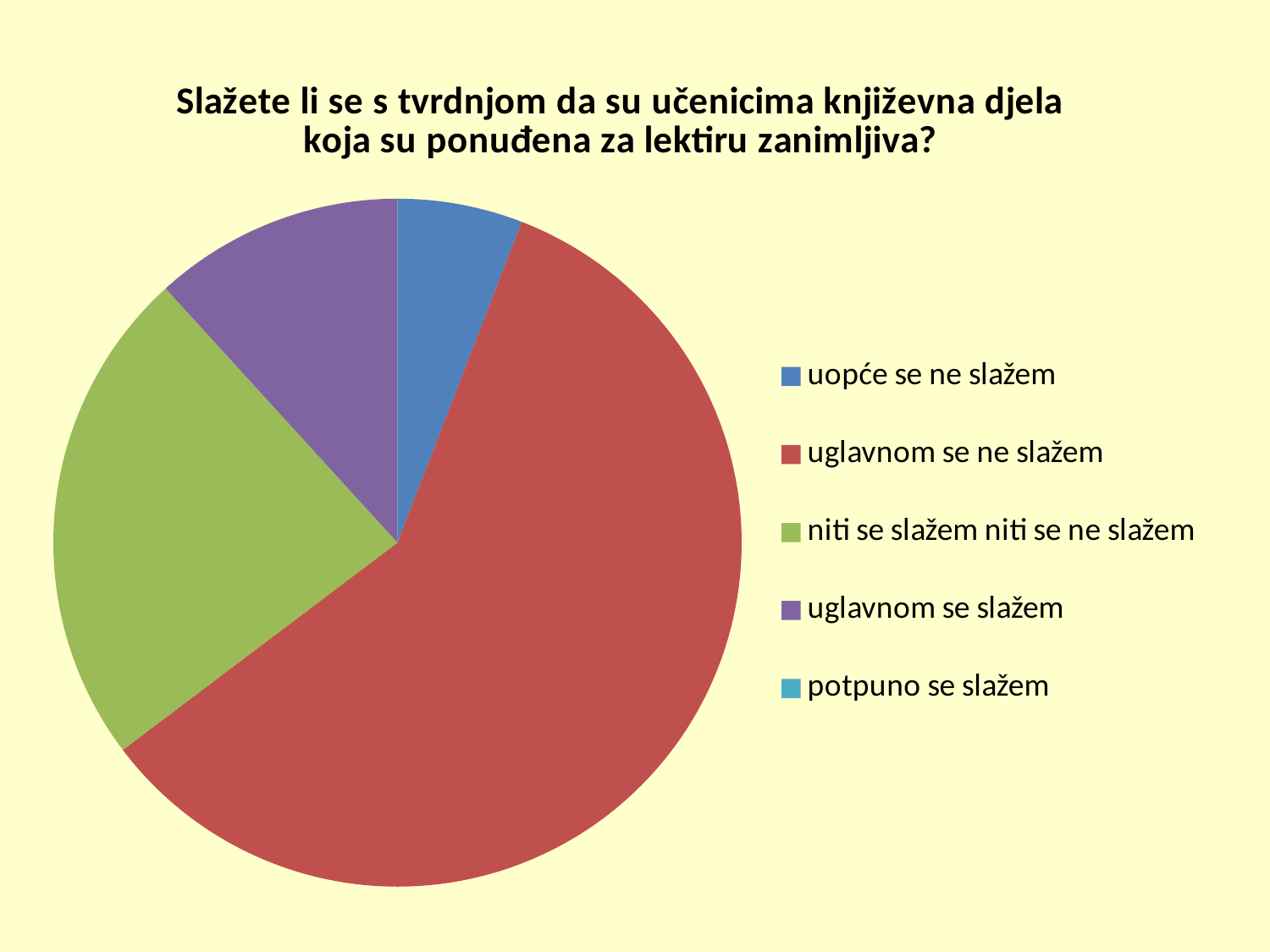
Which slice is larger: "niti se slažem niti se ne slažem" or "uglavnom se ne slažem"? uglavnom se ne slažem What kind of chart is shown on the slide? pie chart How many slices are visible in the pie? 4 What colour is the "uglavnom se ne slažem" slice? red Which slice is larger: "uopće se ne slažem" or "uglavnom se slažem"? uglavnom se slažem How many entries does the legend list? 5 What is the title of the chart? Slažete li se s tvrdnjom da su učenicima književna djela koja su ponuđena za lektiru zanimljiva? Which slice is larger: "niti se slažem niti se ne slažem" or "uglavnom se slažem"? niti se slažem niti se ne slažem Does the "uglavnom se ne slažem" slice take up more or less than half of the pie? more Which category has the largest slice of the pie? uglavnom se ne slažem